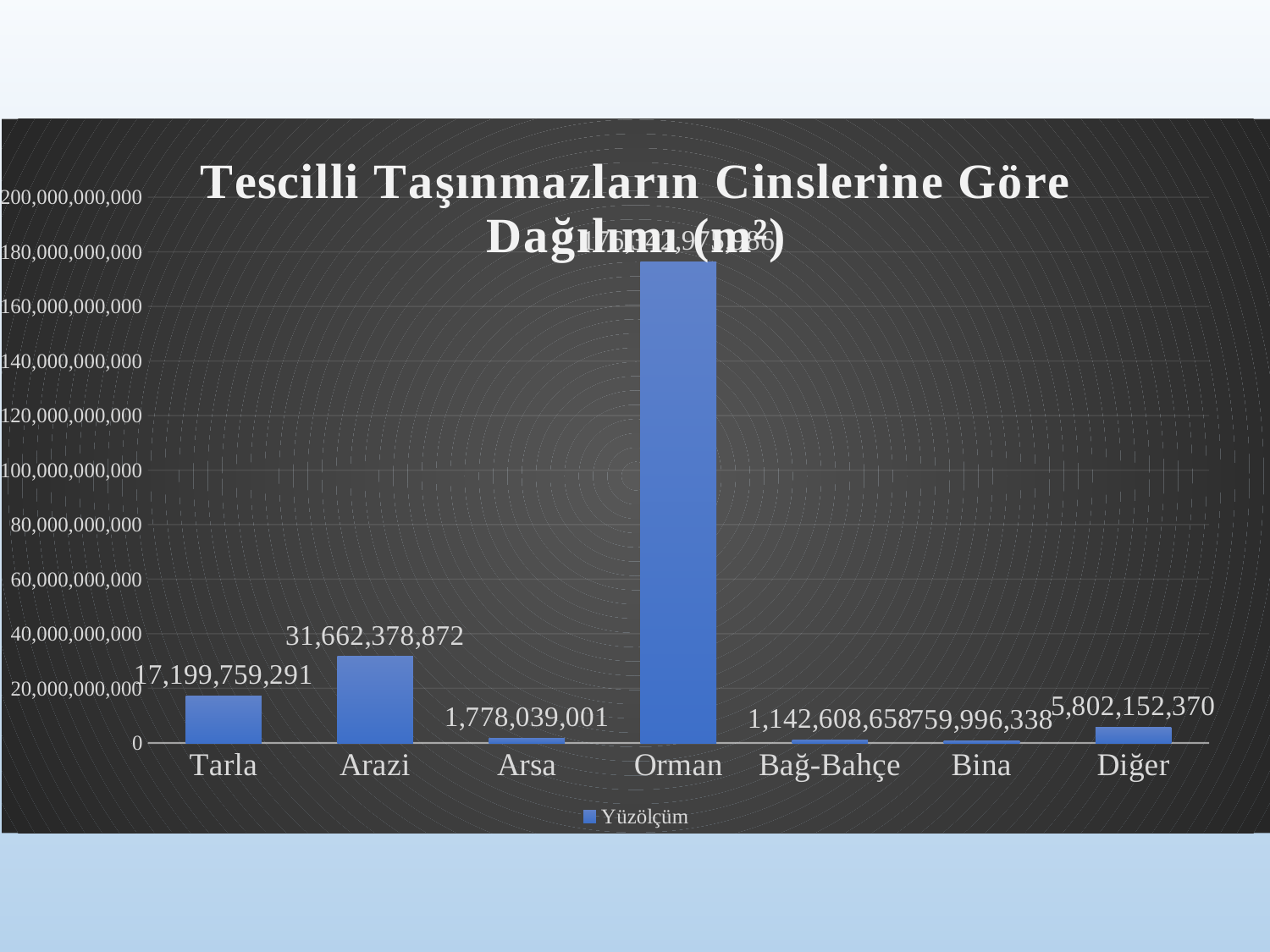
What is the value for Arazi? 31,662,378,872 Is the value for Orman greater or less than 160,000,000,000? greater What is the name of the series listed in the legend? Yüzölçüm Which category has the lowest value? Bina What is the value for Arsa? 1,778,039,001 How many categories are shown on the x axis? 7 What is the value for Tarla? 17,199,759,291 What is the difference between the values for Arazi and Tarla? 14,462,619,581 What is the value for Bağ-Bahçe? 1,142,608,658 What type of chart is shown on the slide? Bar chart What is the value for Diğer? 5,802,152,370 Which category has the highest value? Orman